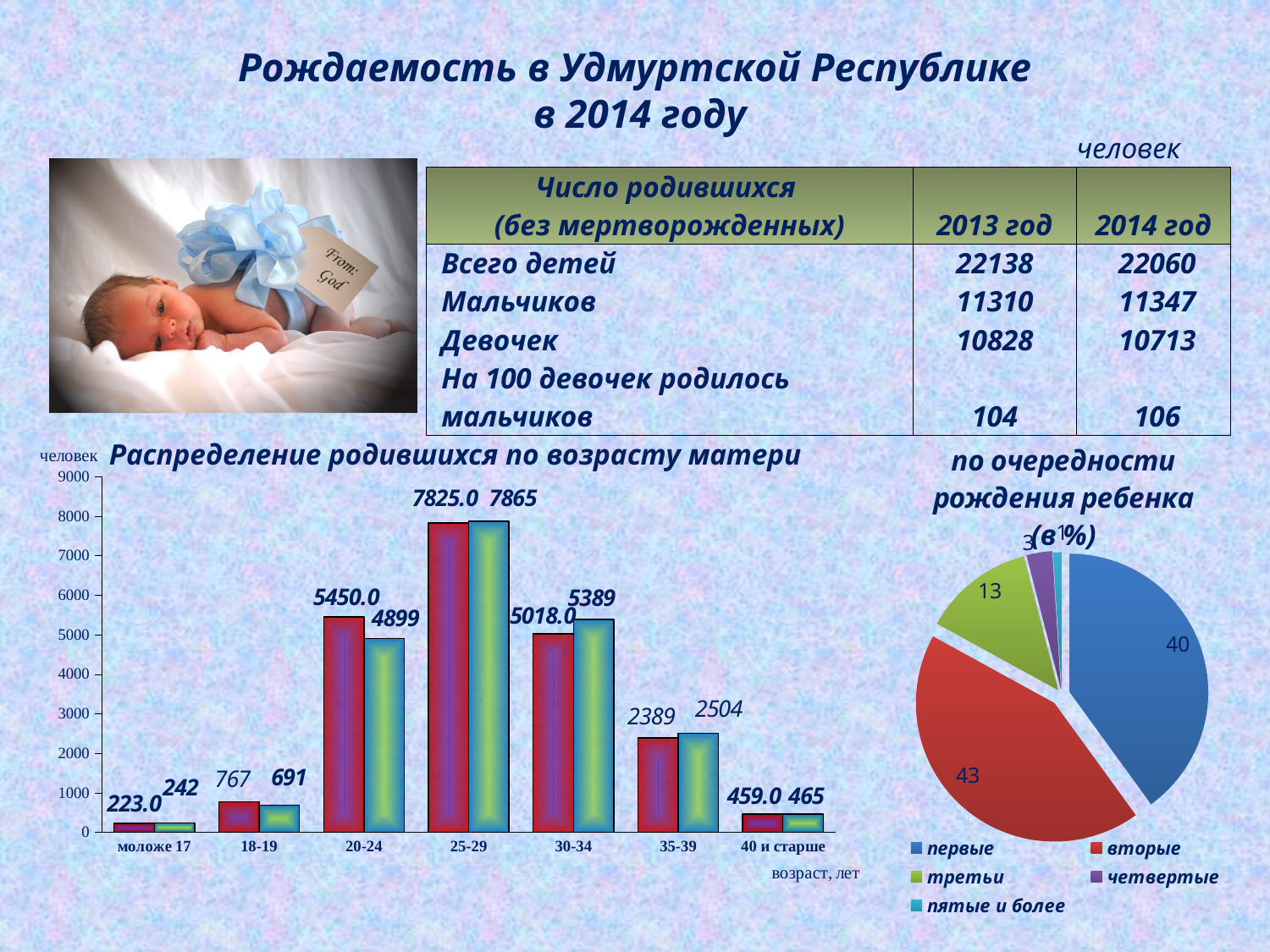
How many categories does the legend of the 'по очередности рождения ребенка (в %)' pie chart list? 5 In the 'Распределение родившихся по возрасту матери' chart, how many age categories are shown on the x axis? 7 In the 'Распределение родившихся по возрасту матери' chart, what is the value of the second (green) bar for the 30-34 age group? 5389 In the 'Распределение родившихся по возрасту матери' chart, which age group has the lowest values? моложе 17 In the 'по очередности рождения ребенка (в %)' pie chart, which category has the smallest slice? пятые и более In the 'Распределение родившихся по возрасту матери' chart, what is the difference between the two bars for the 20-24 age group (5450.0 and 4899)? 551 In the 'Распределение родившихся по возрасту матери' chart, which age group has the highest values? 25-29 What kind of chart is the 'по очередности рождения ребенка (в %)' chart? pie chart What kind of chart is the 'Распределение родившихся по возрасту матери' chart? bar chart In the 'Распределение родившихся по возрасту матери' chart, what is the value of the first (red) bar for the 25-29 age group? 7825.0 In the 'по очередности рождения ребенка (в %)' pie chart, what share do 'вторые' births have? 43 In the 'Распределение родившихся по возрасту матери' chart, for the 35-39 age group, which bar is larger: the first (red) bar or the second (green) bar? the second (green) bar